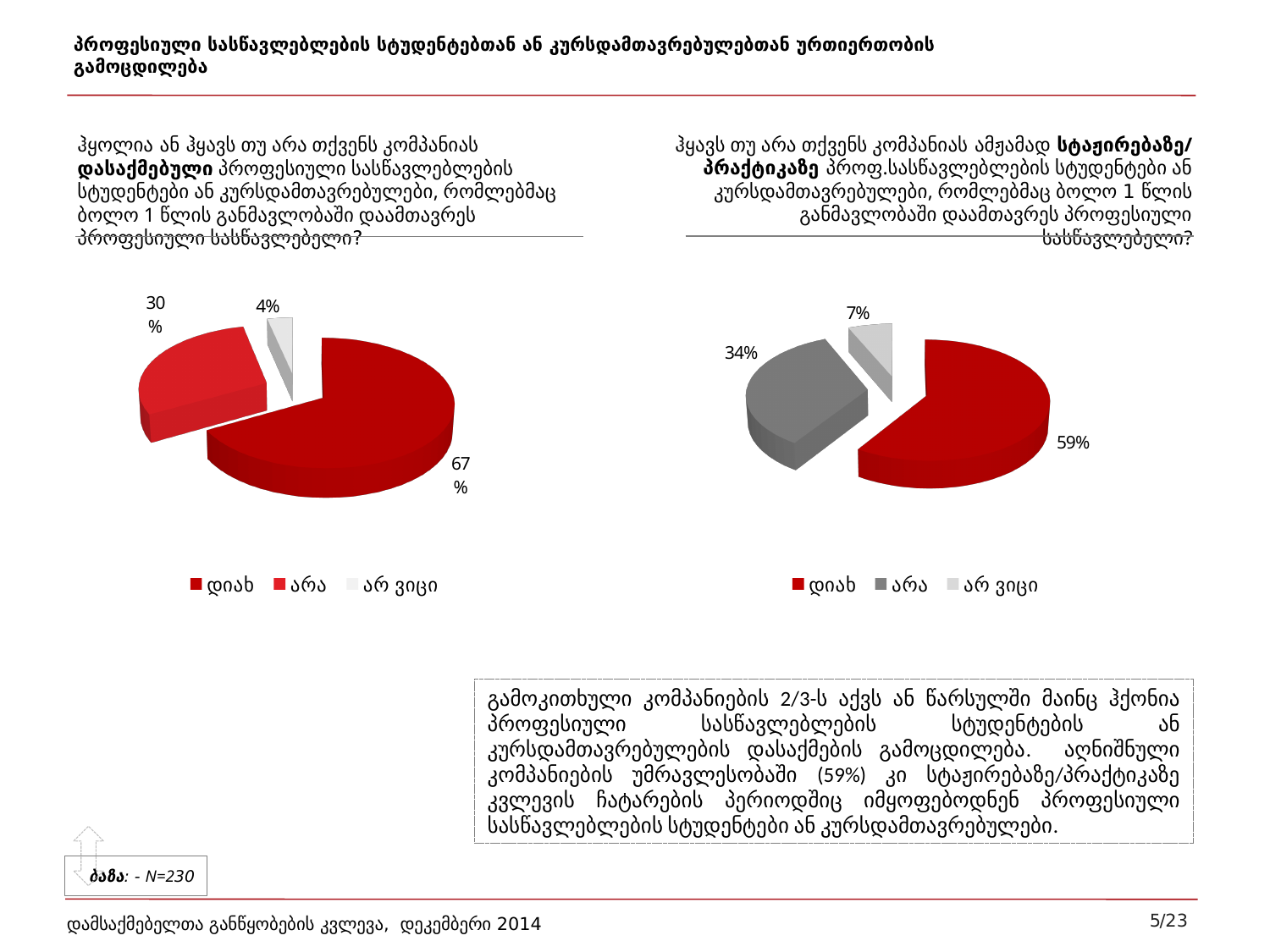
How many entries does the legend of the right pie chart list? 3 What is the difference between the "დიახ" share in the left pie chart and the "დიახ" share in the right pie chart? 8 percentage points In the left pie chart, what share is labelled for the "არა" slice? 30% In the left pie chart, which category has the largest slice? დიახ In the right pie chart, what share is labelled for the "დიახ" slice? 59% In the right pie chart, what share is labelled for the "არა" slice? 34% In the left pie chart, what share is labelled for the "დიახ" slice? 67% Which is larger: the "არა" share in the left pie chart or the "არა" share in the right pie chart? the right pie chart In the right pie chart, what share is labelled for the "არ ვიცი" slice? 7% What type of chart is used on the left side of the slide? pie chart In the right pie chart, which category has the smallest slice? არ ვიცი In the left pie chart, what share is labelled for the "არ ვიცი" slice? 4%